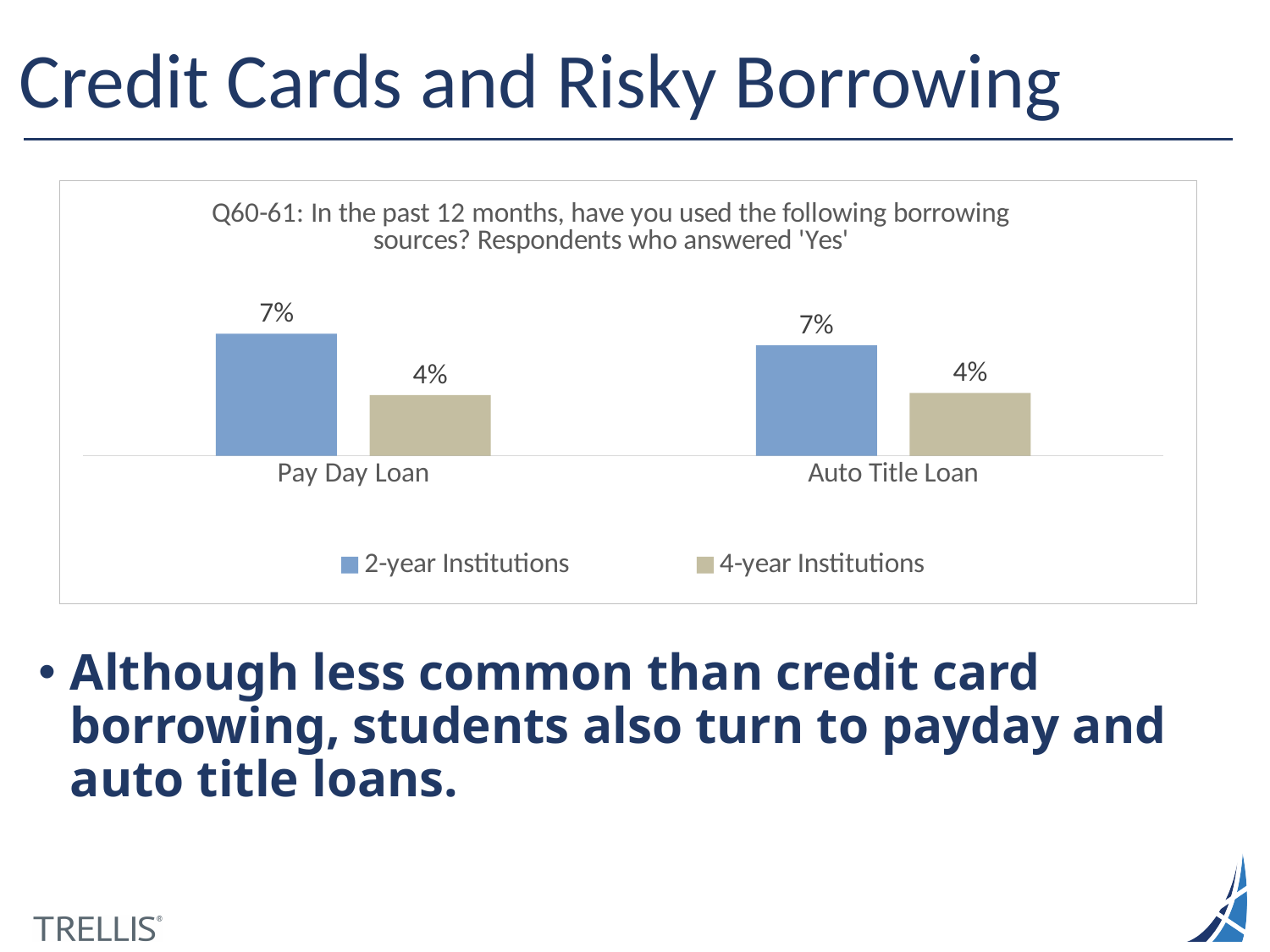
What is the difference between the 2-year and 4-year institution values for Auto Title Loan? 3% Which series is shown in blue in the legend? 2-year Institutions How many borrowing source categories are shown on the x axis? 2 What percentage of respondents at 2-year institutions used an Auto Title Loan? 7% What kind of chart is shown on the slide? Bar chart For Pay Day Loan, which is larger: the value for 2-year Institutions or 4-year Institutions? 2-year Institutions What is the difference between the 2-year and 4-year institution values for Pay Day Loan? 3% How many series does the legend list? 2 For Auto Title Loan, which is larger: the value for 2-year Institutions or 4-year Institutions? 2-year Institutions What percentage of respondents at 4-year institutions used an Auto Title Loan? 4% What percentage of respondents at 4-year institutions used a Pay Day Loan? 4% What percentage of respondents at 2-year institutions used a Pay Day Loan? 7%